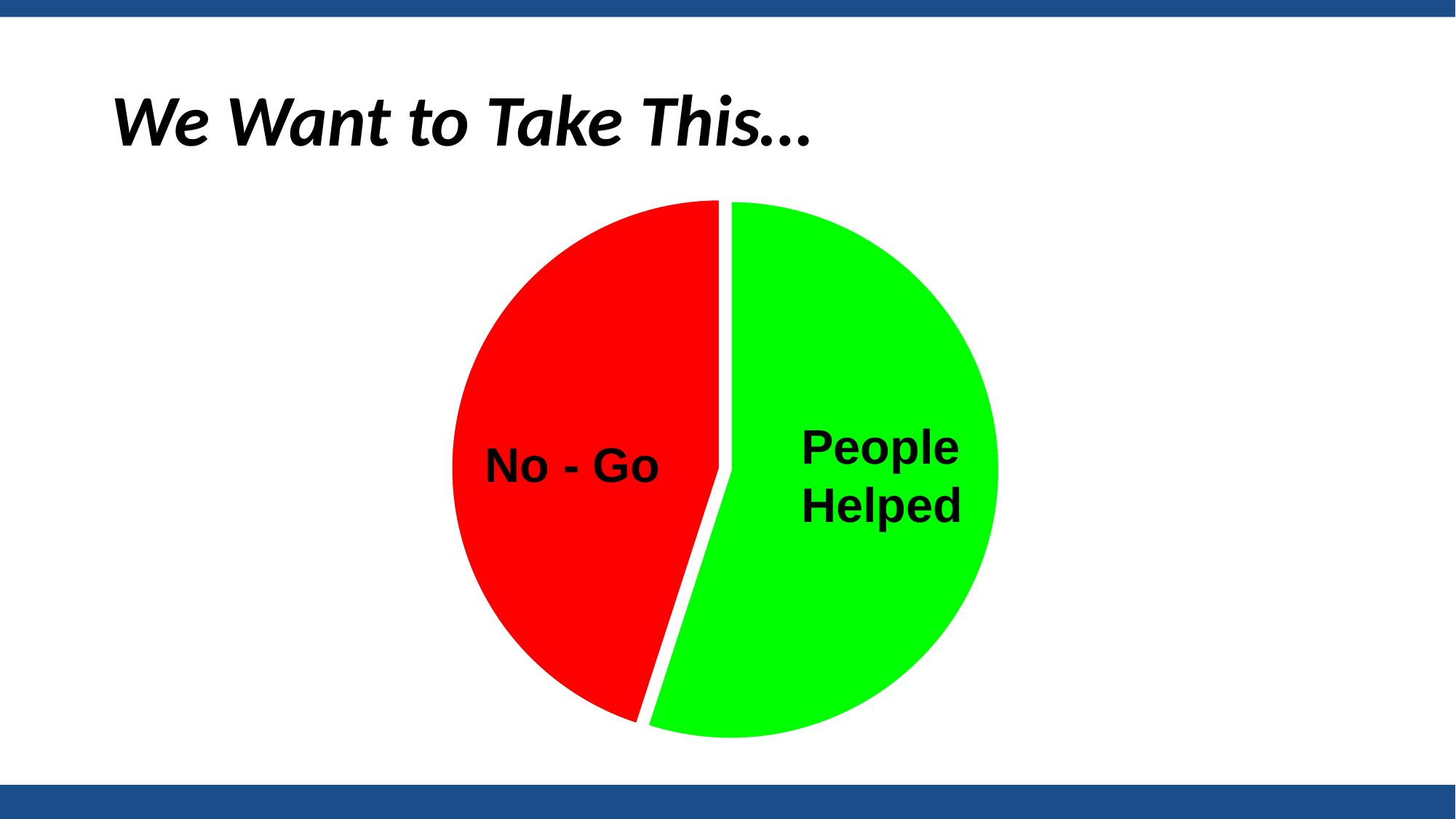
Which slice of the pie chart is the largest? People Helped What colour is the People Helped slice? green Which slice is larger, No - Go or People Helped? People Helped What colour is the No - Go slice? red Is the People Helped slice more or less than half of the pie? more How many slices does the pie chart have? 2 Is the No - Go slice more or less than half of the pie? less What kind of chart is shown on the slide? pie chart Which slice of the pie chart is the smallest? No - Go